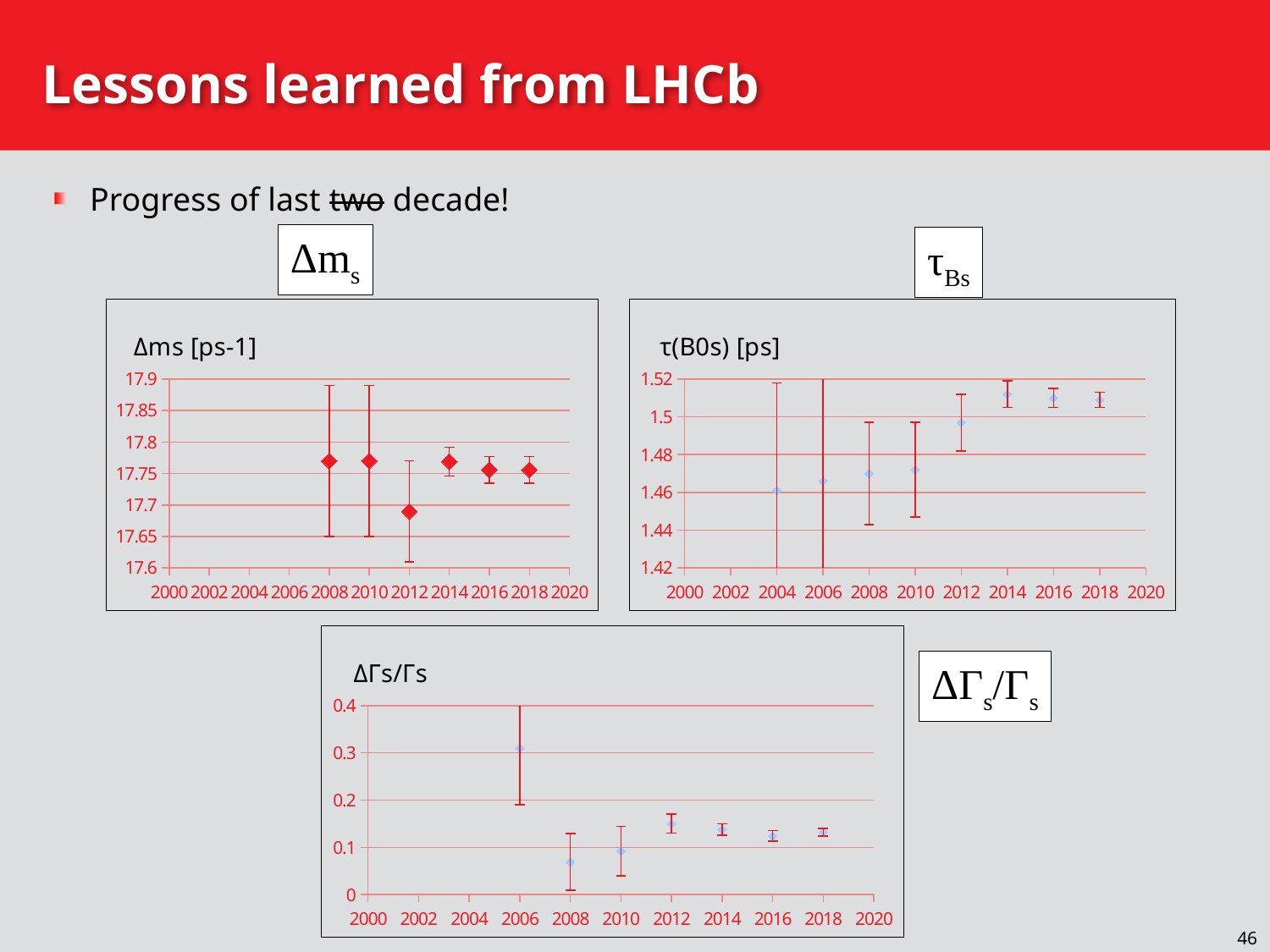
In the ΔΓs/Γs chart, which year has the highest plotted value? 2006 In the Δms [ps-1] chart, which year has the lowest plotted value? 2012 What kind of chart is the ΔΓs/Γs chart? scatter chart with error bars In the Δms [ps-1] chart, is the value for 2008 greater or less than 17.75? greater In the τ(B0s) [ps] chart, which is larger, the value for 2004 or the value for 2014? 2014 In the τ(B0s) [ps] chart, do the values generally rise or fall from 2004 to 2018? rise In the τ(B0s) [ps] chart, is the value for 2014 greater or less than 1.5? greater In the ΔΓs/Γs chart, is the value for 2008 greater or less than 0.1? less How many data points are plotted in the Δms [ps-1] chart? 6 How many data points are plotted in the τ(B0s) [ps] chart? 8